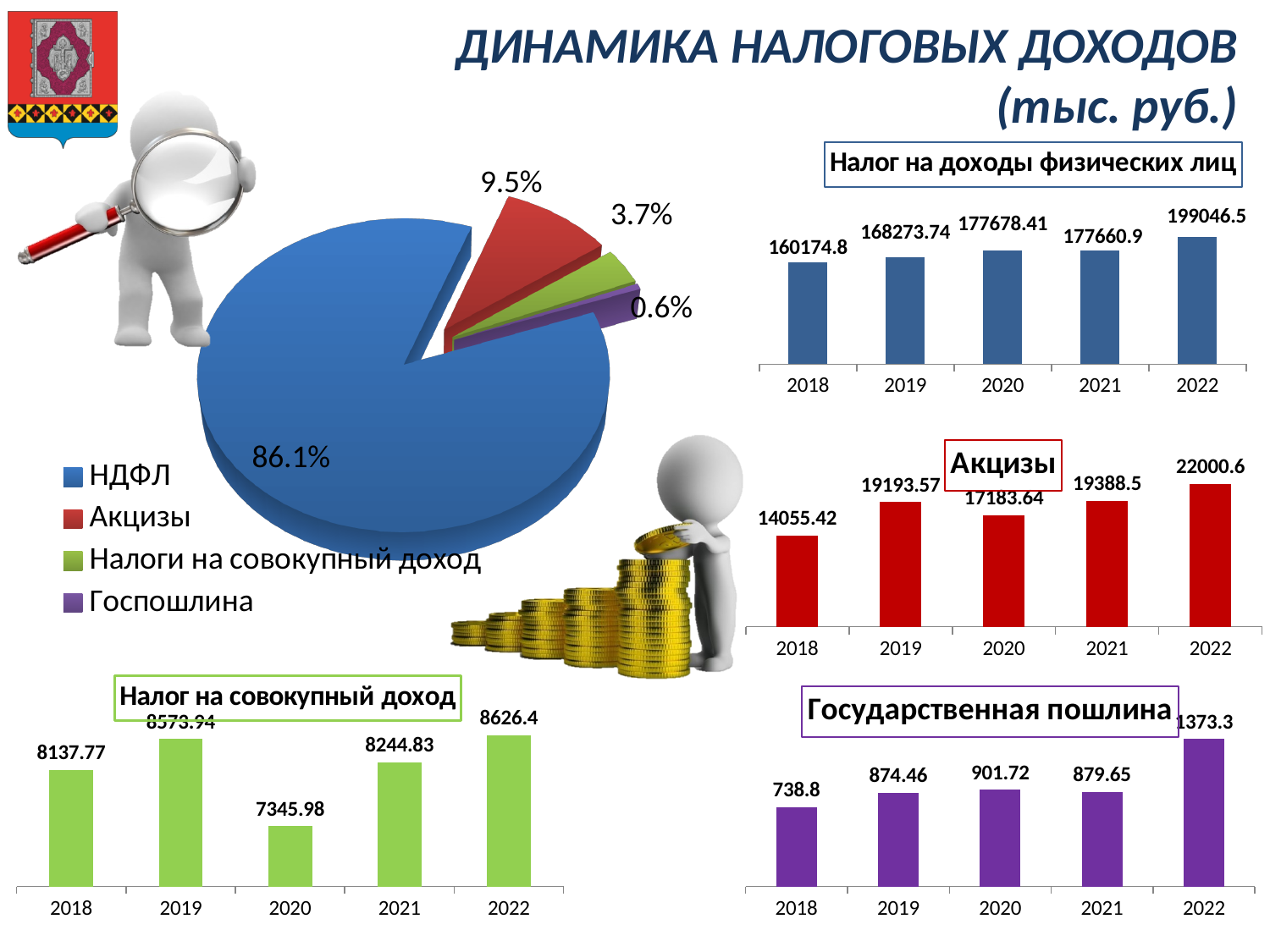
In the chart titled 'Акцизы', what is the value for 2020? 17183.64 In the chart titled 'Государственная пошлина', what is the value for 2019? 874.46 In the pie chart on the left, what share does НДФЛ have? 86.1% In the chart titled 'Акцизы', which year has the highest value? 2022 In the chart titled 'Налог на доходы физических лиц', which year has the lowest value? 2018 In the chart titled 'Налог на совокупный доход', which is larger, the value for 2021 or the value for 2022? 2022 What type of chart is the chart titled 'Государственная пошлина'? bar chart In the chart titled 'Акцизы', what is the difference between the values for 2022 and 2018? 7945.18 In the chart titled 'Налог на доходы физических лиц', what is the value for 2022? 199046.5 In the chart titled 'Налог на совокупный доход', what is the value for 2020? 7345.98 In the pie chart on the left, what share does Госпошлина have? 0.6% How many entries does the legend of the pie chart on the left list? 4